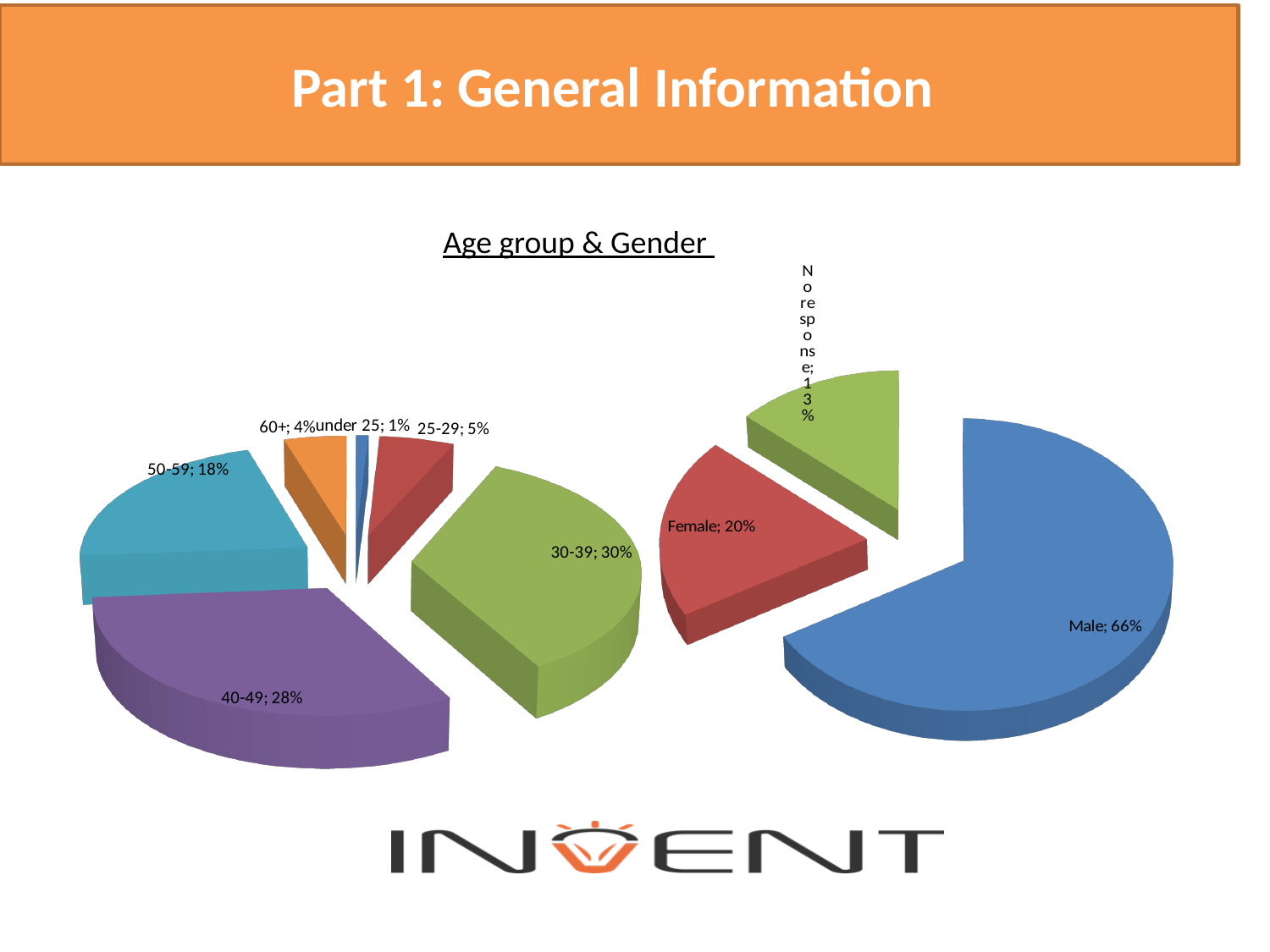
On the left pie chart (age group), which age group has the largest share? 30-39 On the left pie chart (age group), what share is the 30-39 slice? 30% On the left pie chart (age group), how many slices are there? 6 On the right pie chart (gender), what share is the Male slice? 66% On the right pie chart (gender), what share is the Female slice? 20% On the left pie chart (age group), what share is the 50-59 slice? 18% On the left pie chart (age group), what is the difference between the 50-59 share and the 60+ share? 14% On the left pie chart (age group), what share is the 40-49 slice? 28% On the right pie chart (gender), how many slices are there? 3 On the left pie chart (age group), which age group has the smallest share? under 25 What type of charts are shown on the slide? Pie charts On the right pie chart (gender), which is larger, the Female slice or the No response slice? Female